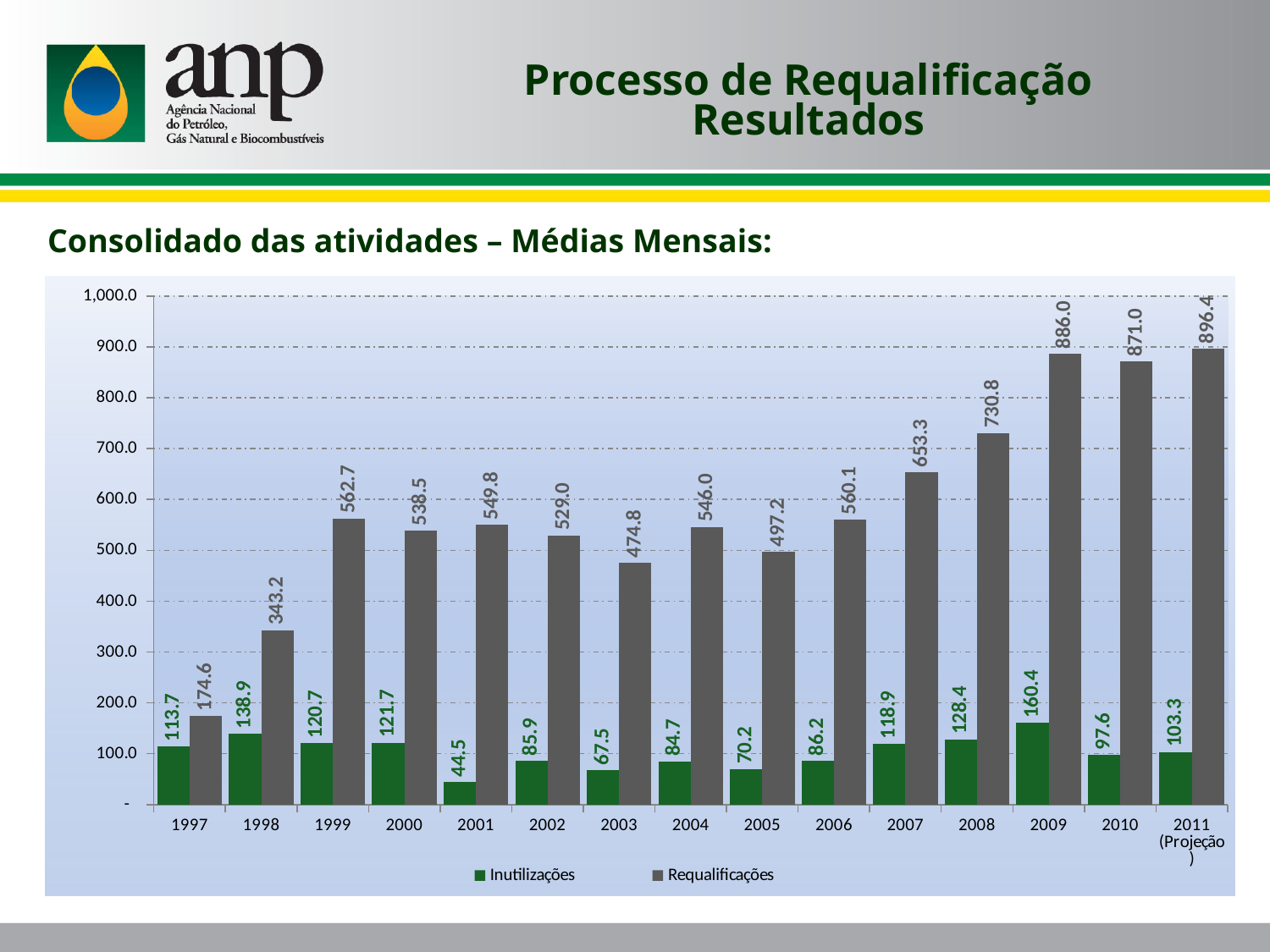
What is the difference between the Requalificações values for 2011 (Projeção) and 2010? 25.4 What is the value of Requalificações for 2009? 886.0 Which year has the lowest value for Requalificações? 1997 What is the value of Requalificações for 2011 (Projeção)? 896.4 Which year has the highest value for Inutilizações? 2009 Which is larger, Requalificações in 1999 or Requalificações in 2000? 1999 How many years are shown on the x axis? 15 How many series does the legend list? 2 What is the difference between Requalificações and Inutilizações in 2009? 725.6 What is the value of Inutilizações for 2001? 44.5 What kind of chart is shown on the slide? Bar chart Is the value of Requalificações for 2008 greater or less than 700? greater